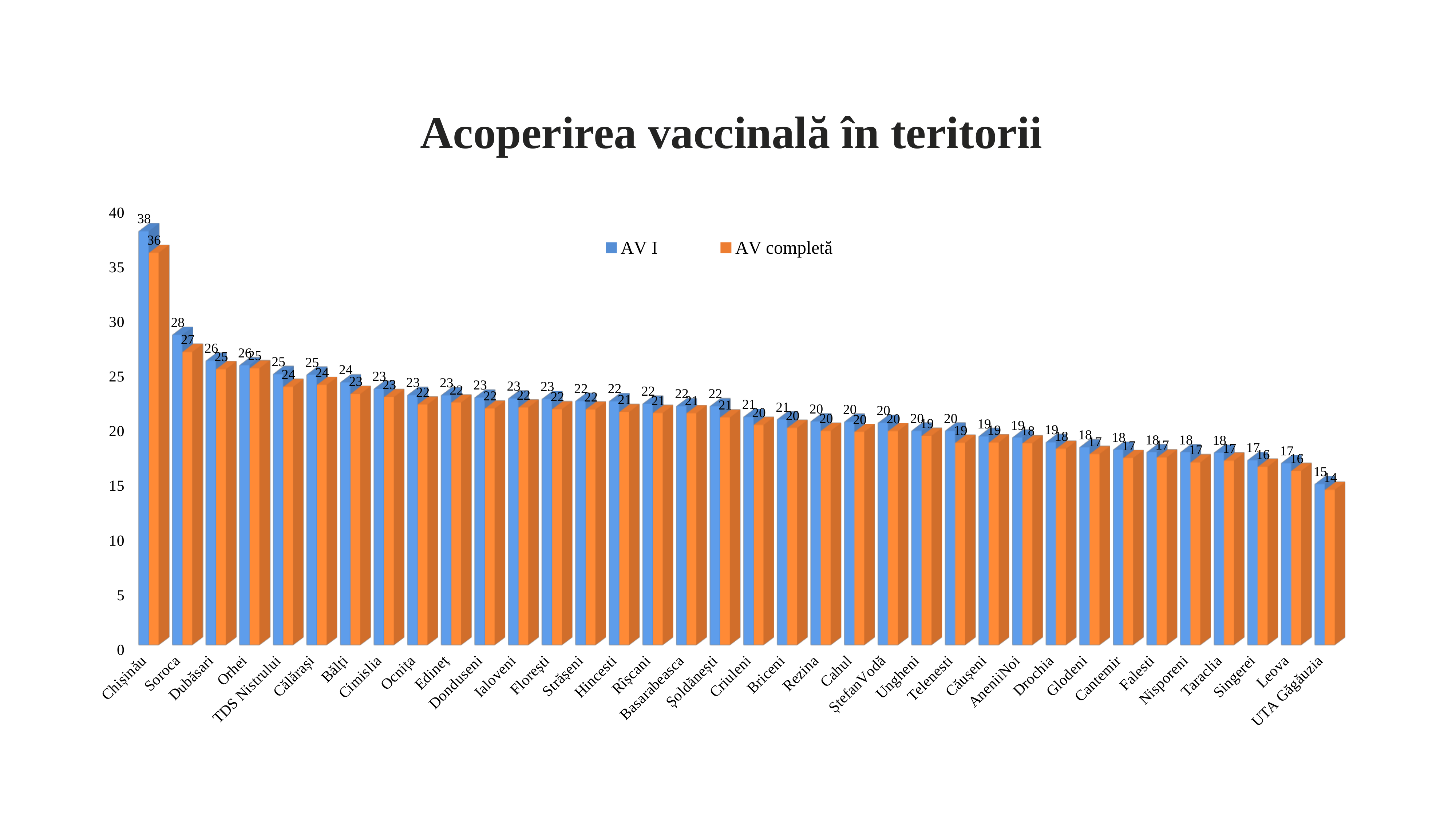
What is the AV completă value for UTA Găgăuzia? 14 Is the AV I value for Chișinău greater or less than 35? greater How many series does the legend list? 2 Which is larger, the AV I value for Soroca or the AV I value for Leova? Soroca Which territory has the highest AV I value? Chișinău What is the difference between the AV I and AV completă values for Chișinău? 2 How many territories are shown on the x axis? 36 What kind of chart is shown on the slide? bar chart What is the AV completă value for Soroca? 27 What is the AV I value for Chișinău? 38 Do the AV I values rise or fall from left to right along the x axis? fall Which territory has the lowest AV completă value? UTA Găgăuzia